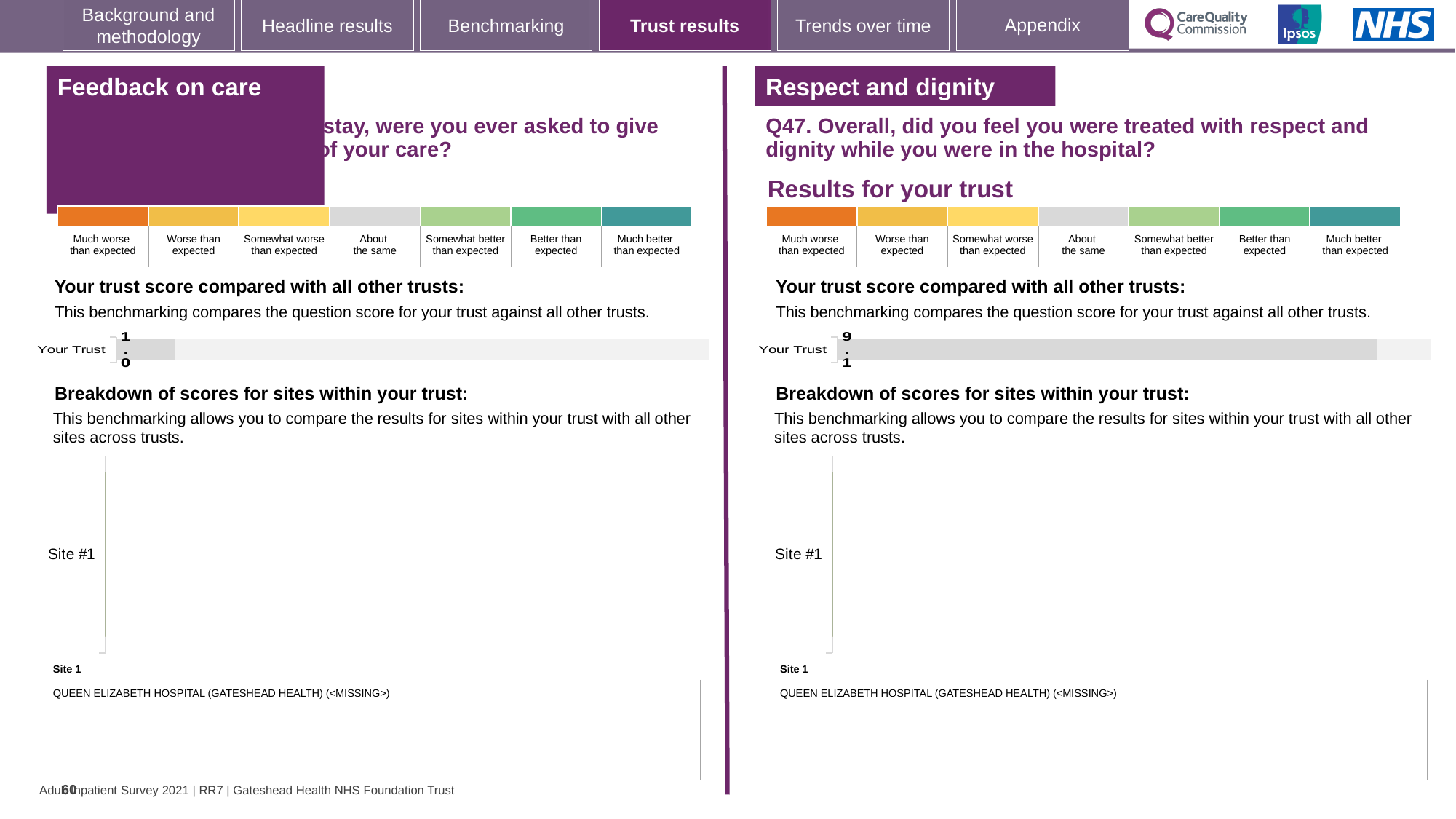
In the Feedback on care chart, how many categories are plotted in the 'Your trust score compared with all other trusts' chart? 1 How many colour bands are shown in the scale above the Respect and dignity chart? 7 In the Feedback on care chart, what is the score shown for Your Trust? 1.0 In the Respect and dignity section, how many sites are listed in the breakdown of scores for sites within your trust? 1 In the Respect and dignity chart, is the Your Trust score greater or less than 5? greater In the Respect and dignity chart, what is the score shown for Your Trust? 9.1 What kind of chart is used to show the Your Trust score in the Respect and dignity section? bar chart What is the difference between the Your Trust score in the Respect and dignity chart and the Your Trust score in the Feedback on care chart? 8.1 Which chart shows the larger Your Trust score, Feedback on care or Respect and dignity? Respect and dignity In the Respect and dignity chart, what is the label of the leftmost (orange) band of the scale? Much worse than expected In the Feedback on care chart, is the Your Trust score greater or less than 5? less